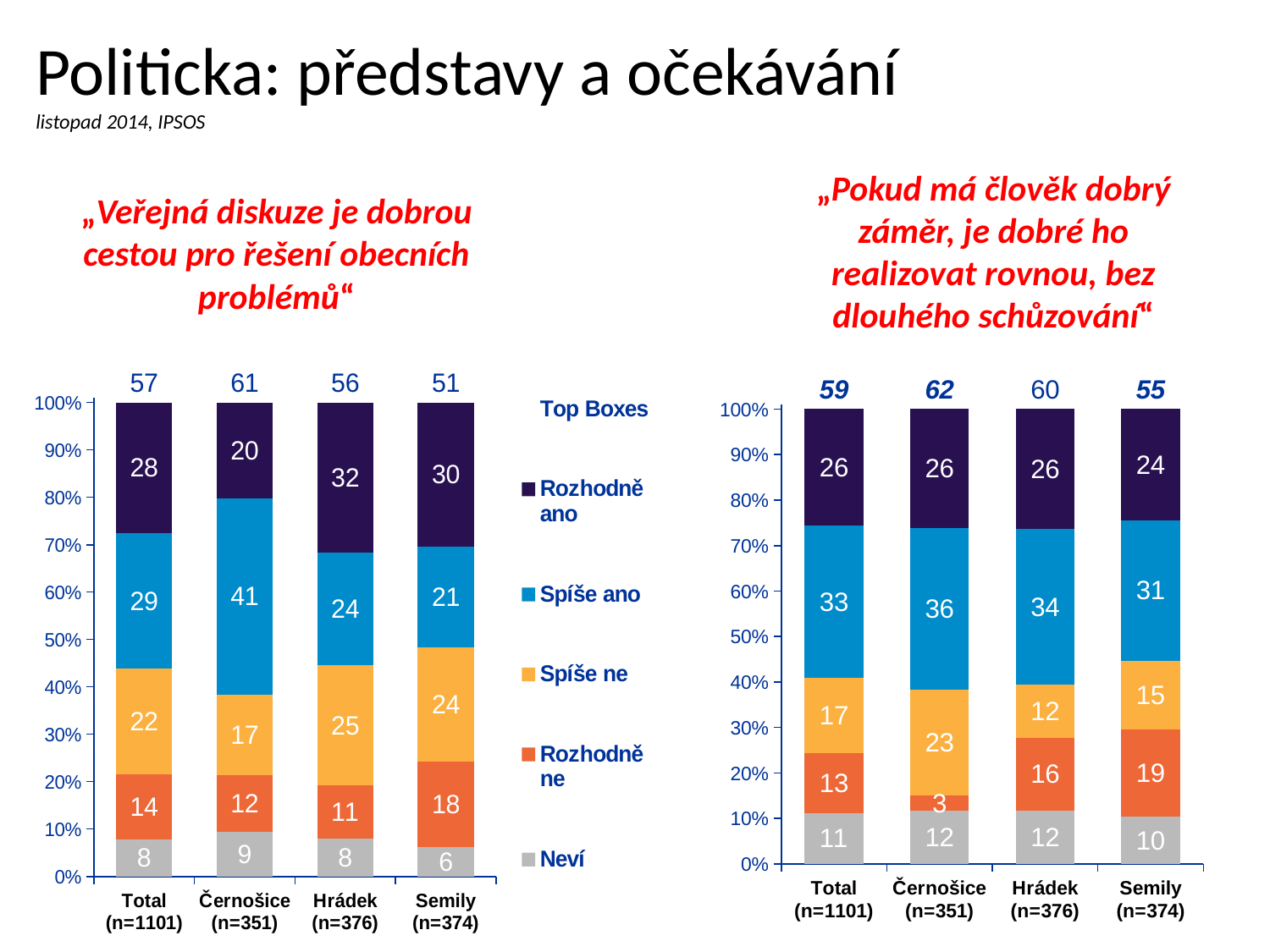
In the left chart ("Veřejná diskuze je dobrou cestou pro řešení obecních problémů"), what is the Top Boxes value for Semily? 51 In the right chart ("Pokud má člověk dobrý záměr..."), what is the total of "Rozhodně ano" and "Spíše ano" for Total (n=1101)? 59 In the right chart ("Pokud má člověk dobrý záměr..."), what is the value of "Rozhodně ne" for Černošice? 3 In the right chart ("Pokud má člověk dobrý záměr..."), which category has the highest Top Boxes value? Černošice How many categories are shown on the x axis of the right chart ("Pokud má člověk dobrý záměr...")? 4 In the right chart ("Pokud má člověk dobrý záměr..."), which is larger: "Spíše ano" for Hrádek or "Spíše ano" for Semily? Hrádek In the left chart ("Veřejná diskuze je dobrou cestou pro řešení obecních problémů"), what is the difference between the Top Boxes values for Černošice and Semily? 10 Which legend entry is shown in the darkest colour at the top of each stacked bar? Rozhodně ano In the left chart ("Veřejná diskuze je dobrou cestou pro řešení obecních problémů"), what is the value of "Spíše ano" for Černošice? 41 In the left chart ("Veřejná diskuze je dobrou cestou pro řešení obecních problémů"), which category has the lowest "Neví" value? Semily What type of chart is the left chart ("Veřejná diskuze je dobrou cestou pro řešení obecních problémů")? Stacked bar chart